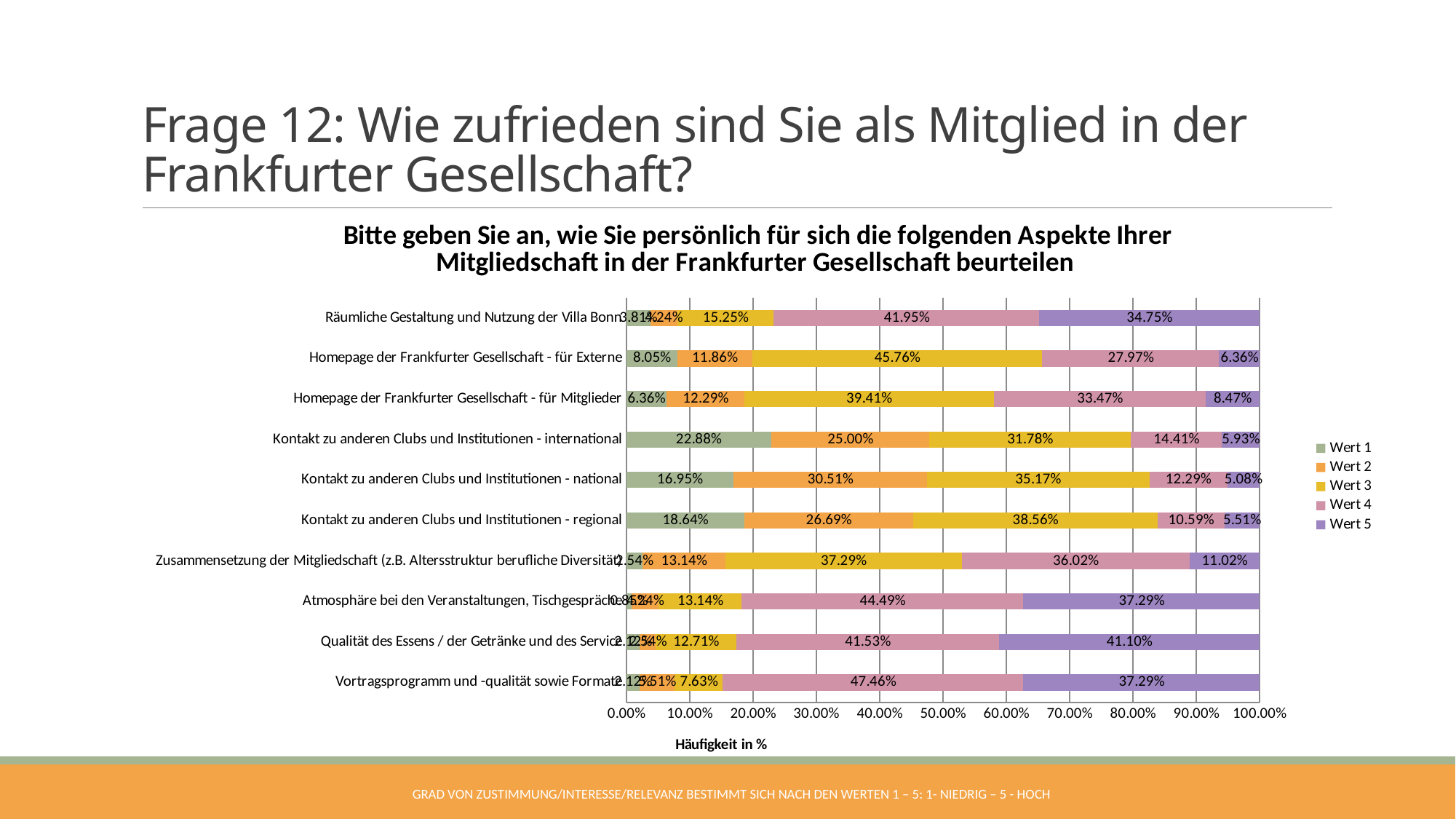
How many series does the legend list? 5 What is the Wert 4 value for 'Vortragsprogramm und -qualität sowie Formate'? 47.46% Which category has the lowest Wert 5 value? Kontakt zu anderen Clubs und Institutionen - national Which category has the highest Wert 5 value? Qualität des Essens / der Getränke und des Service What is the Wert 5 value for 'Qualität des Essens / der Getränke und des Service'? 41.10% What is the Wert 3 value for 'Homepage der Frankfurter Gesellschaft - für Externe'? 45.76% What is the title of the horizontal axis? Häufigkeit in % What kind of chart is shown on the slide? Stacked bar chart What is the difference between the Wert 4 values for 'Räumliche Gestaltung und Nutzung der Villa Bonn' and 'Homepage der Frankfurter Gesellschaft - für Mitglieder'? 8.48% Which is larger: the Wert 2 value for 'Kontakt zu anderen Clubs und Institutionen - national' or for 'Kontakt zu anderen Clubs und Institutionen - regional'? Kontakt zu anderen Clubs und Institutionen - national How many categories (aspects) are plotted on the chart? 10 What is the Wert 1 value for 'Kontakt zu anderen Clubs und Institutionen - international'? 22.88%